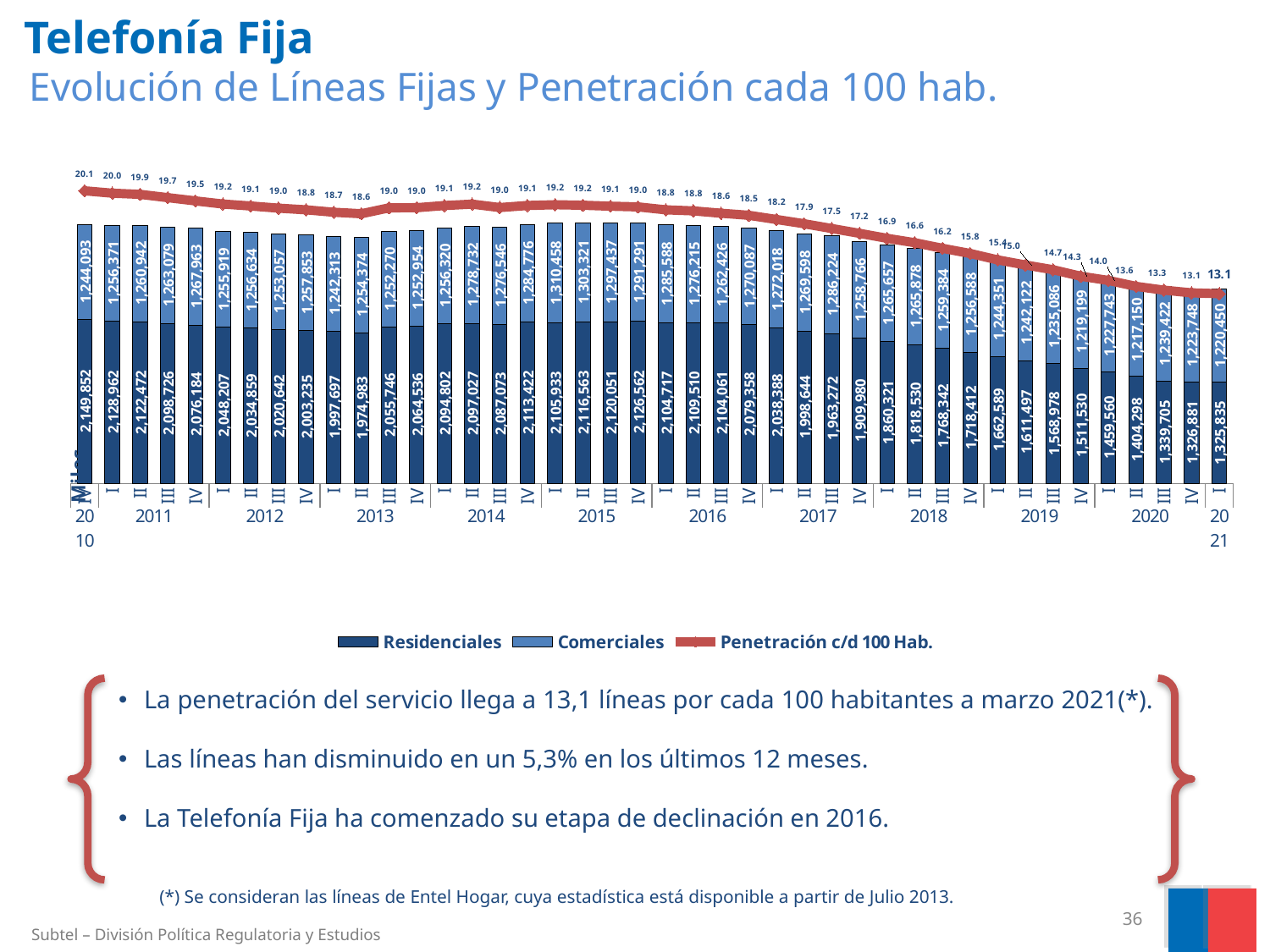
In which period is the Comerciales value highest? I 2015 (1,310,458) What is the Residenciales value for I 2020? 1,459,560 What is the Residenciales value for I 2021? 1,325,835 How many series does the legend list? 3 What is the difference between the Residenciales value for I 2020 and for I 2021? 133,725 What is the total of the stacked bar for I 2021 (Residenciales plus Comerciales)? 2,546,285 What is the Comerciales value for I 2021? 1,220,450 How many quarterly bars are plotted in the chart? 42 In which period is the Penetración c/d 100 Hab. line highest? IV 2010 (20.1) What is the Penetración c/d 100 Hab. value for I 2021? 13.1 Does the Penetración c/d 100 Hab. line rise or fall from 2016 to 2021? Fall Which is larger, the Residenciales value for I 2019 or for I 2020? I 2019